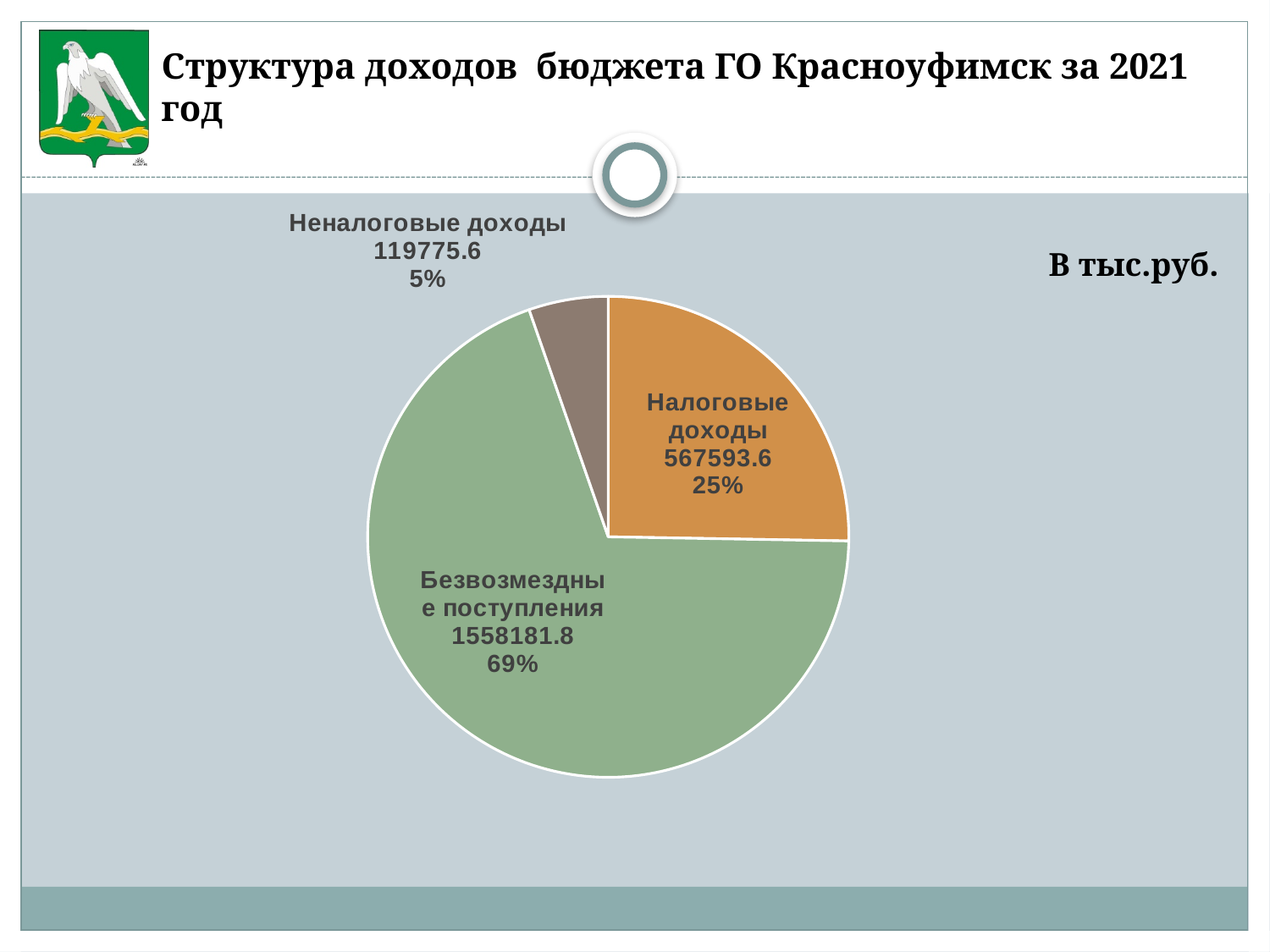
How many slices does the pie chart have? 3 What is the value for Безвозмездные поступления? 1558181.8 What kind of chart is shown on the slide? pie chart What is the value for Налоговые доходы? 567593.6 What share of the pie does Неналоговые доходы represent? 5% Which category has the largest slice? Безвозмездные поступления What share of the pie does Налоговые доходы represent? 25% What is the difference between Налоговые доходы and Неналоговые доходы? 447818.0 What is the value for Неналоговые доходы? 119775.6 Which is larger, Налоговые доходы or Неналоговые доходы? Налоговые доходы Which category has the smallest slice? Неналоговые доходы What share of the pie does Безвозмездные поступления represent? 69%